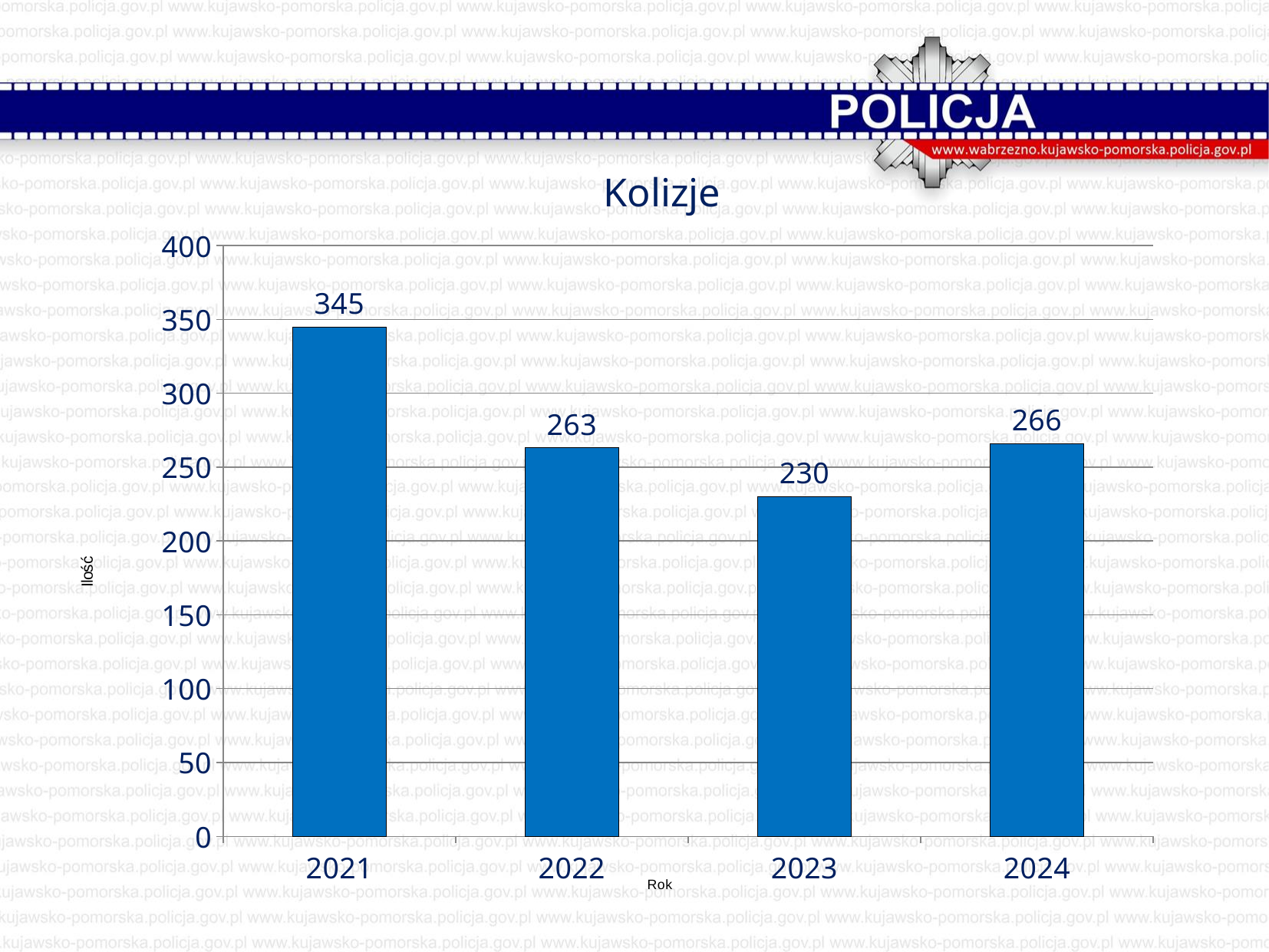
What is the value for 2023 in the Kolizje chart? 230 Is the value for 2023 greater or less than 250? less What is the value for 2021 in the Kolizje chart? 345 What is the title of the chart? Kolizje What is the difference between the values for 2021 and 2022? 82 Which year has the highest value in the Kolizje chart? 2021 What kind of chart is shown on the slide? bar chart Which is larger, the value for 2022 or the value for 2024? 2024 What is the value for 2024 in the Kolizje chart? 266 How many years are shown on the x axis of the chart? 4 What is the difference between the values for 2024 and 2023? 36 Which year has the lowest value in the Kolizje chart? 2023